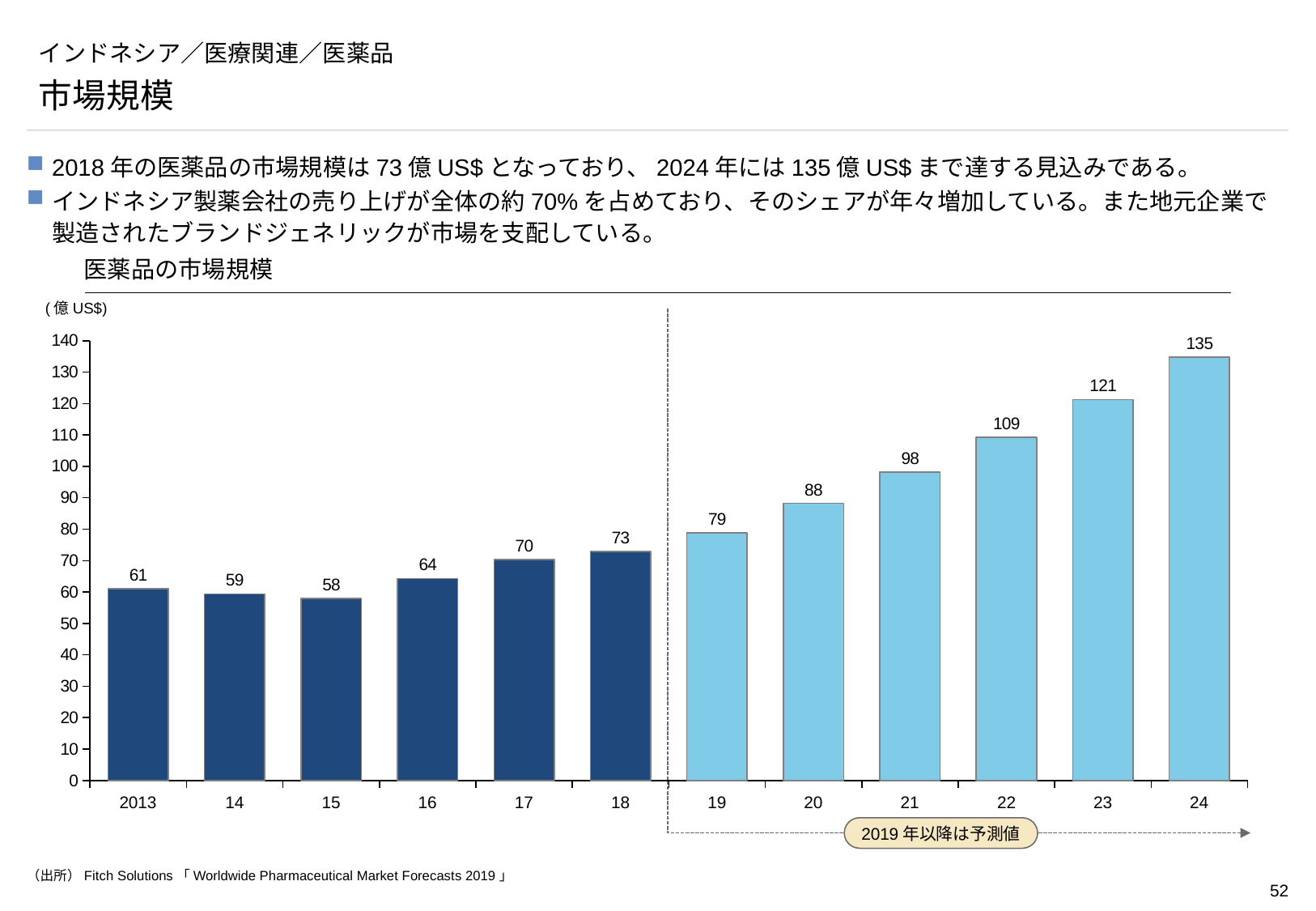
Which is larger in the 医薬品の市場規模 chart, the value for 2013 or the value for 2016? 2016 What is the value for 2024 in the 医薬品の市場規模 chart? 135 Do the values in the 医薬品の市場規模 chart rise or fall from 2018 to 2024? rise What is the value for 2018 in the 医薬品の市場規模 chart? 73 Is the value for 2022 greater or less than 100 in the 医薬品の市場規模 chart? greater What kind of chart is the 医薬品の市場規模 chart? bar chart Which year has the lowest value in the 医薬品の市場規模 chart? 2015 How many years are plotted in the 医薬品の市場規模 chart? 12 What is the difference between the values for 2024 and 2018 in the 医薬品の市場規模 chart? 62 What unit is shown on the y axis of the 医薬品の市場規模 chart? 億 US$ Which year has the highest value in the 医薬品の市場規模 chart? 2024 What is the value for 2015 in the 医薬品の市場規模 chart? 58